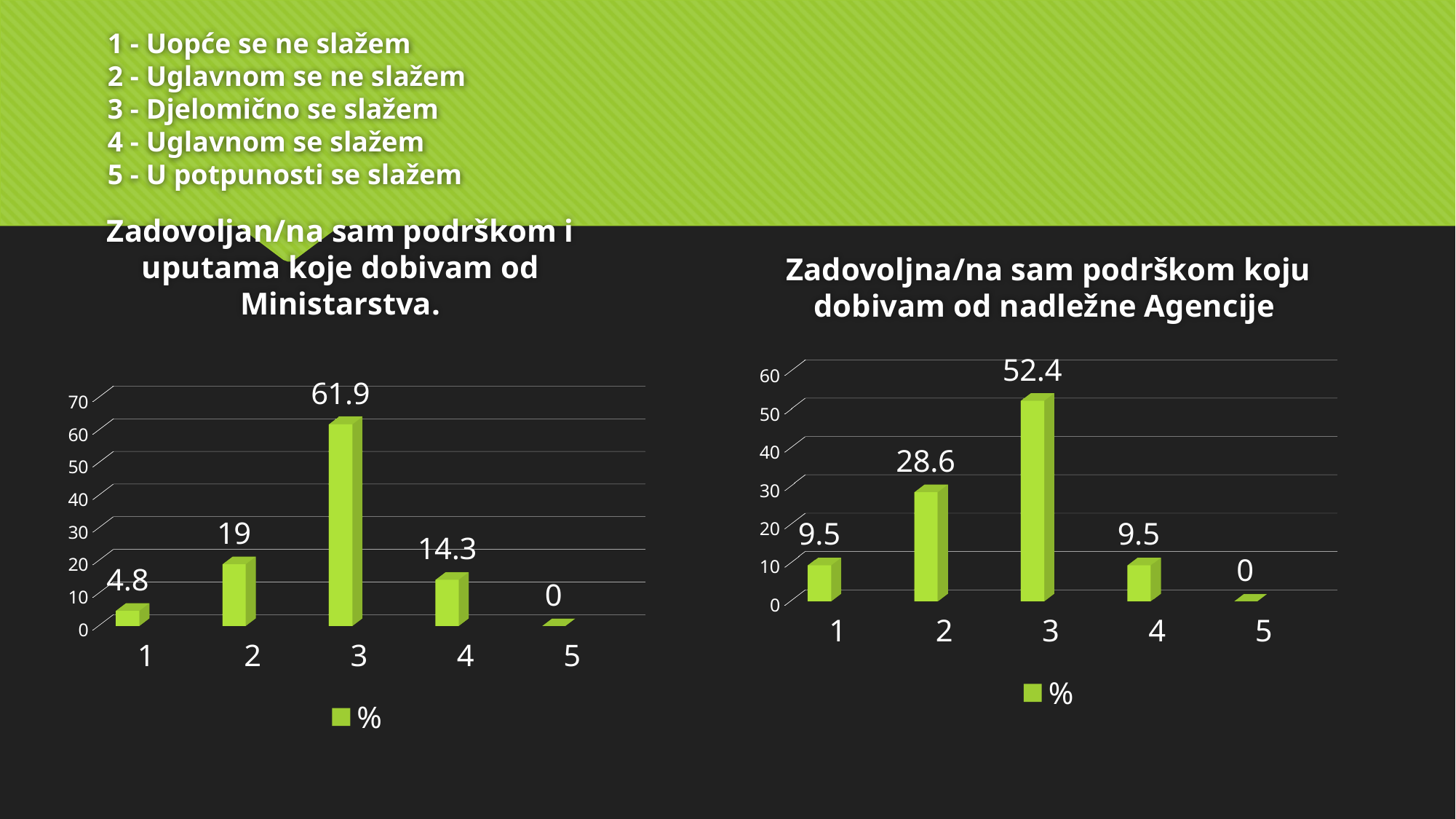
What kind of chart is the left chart (Ministarstva)? bar chart In the left chart (Ministarstva), which is larger, the value for category 2 or category 4? 2 In the left chart (Ministarstva), what is the value for category 1? 4.8 How many categories are shown on the x axis of the right chart (Agencije)? 5 In the right chart (Agencije), which category has the lowest value? 5 What is the legend entry shown below the right chart (Agencije)? % In the right chart (Agencije), what is the value for category 5? 0 In the left chart (Zadovoljan/na sam podrškom i uputama koje dobivam od Ministarstva), what is the value for category 3? 61.9 In the right chart (Agencije), what is the difference between the values for category 3 and category 2? 23.8 In the right chart (Zadovoljna/na sam podrškom koju dobivam od nadležne Agencije), what is the value for category 2? 28.6 In the left chart (Ministarstva), what is the difference between the values for category 3 and category 2? 42.9 In the left chart (Ministarstva), which category has the highest value? 3